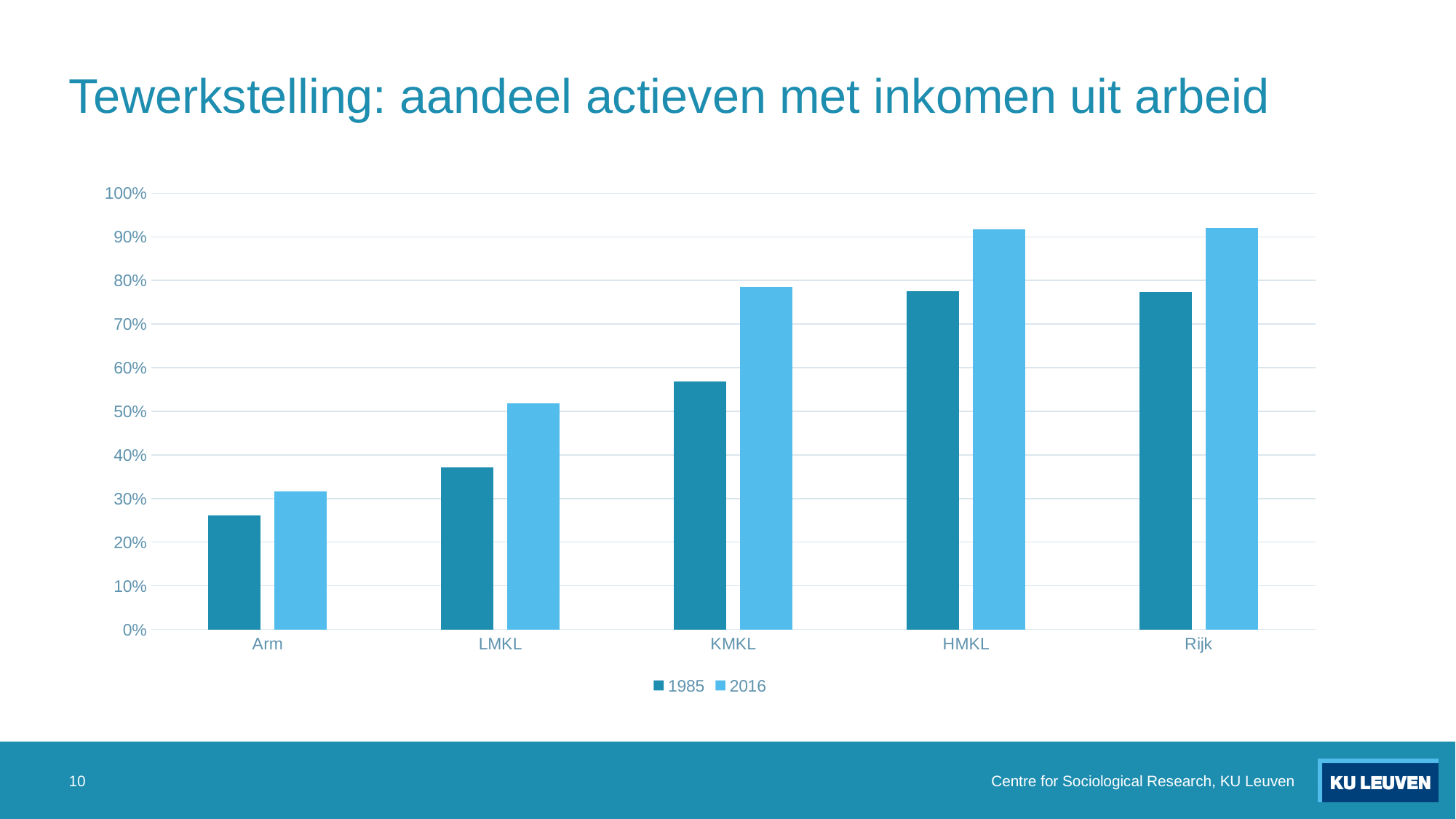
Which category has the lowest value for 1985? Arm Is the value for LMKL in 2016 greater or less than 60%? less Is the value for Arm in 1985 greater or less than 30%? less How many series does the legend list? 2 Which category has the lowest value for 2016? Arm Is the value for Rijk in 1985 greater or less than 80%? less For KMKL, which series has the larger value, 1985 or 2016? 2016 What kind of chart is shown on the slide? bar chart How many categories are shown on the x axis? 5 Do the 2016 values generally rise or fall from Arm to Rijk along the x axis? rise